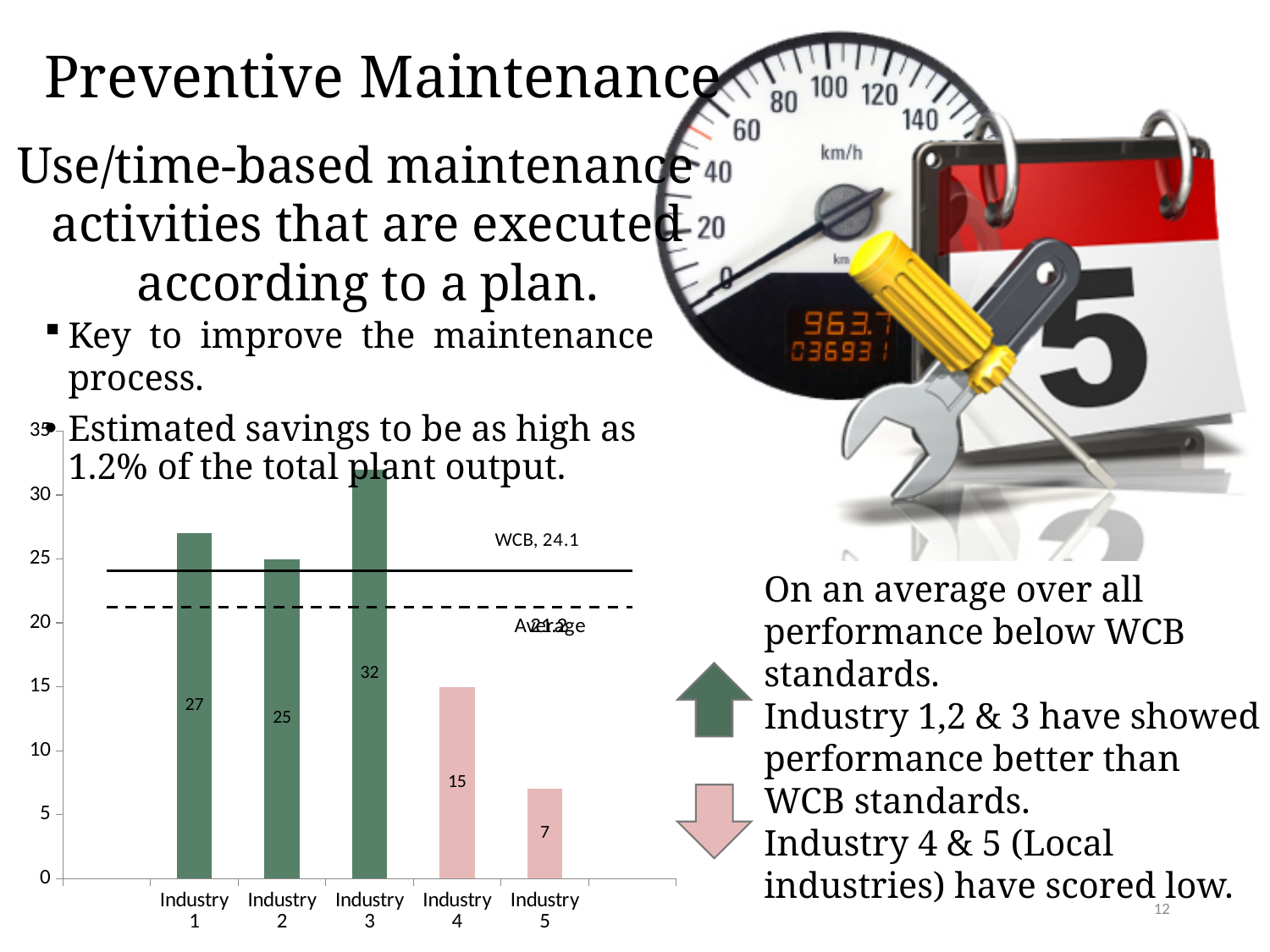
What is the value for Industry 1? 27 How many industries are shown on the x axis? 5 What kind of chart is shown on the slide? bar chart What is the difference between the values for Industry 3 and Industry 5? 25 Which industry has the highest value? Industry 3 What is the difference between the values for Industry 1 and Industry 4? 12 Is the value for Industry 4 greater or less than 20? less What is the value for Industry 5? 7 What is the value for Industry 4? 15 Which industry has the lowest value? Industry 5 What value is labelled for the WCB line on the chart? 24.1 Which is larger, the value for Industry 1 or Industry 2? Industry 1